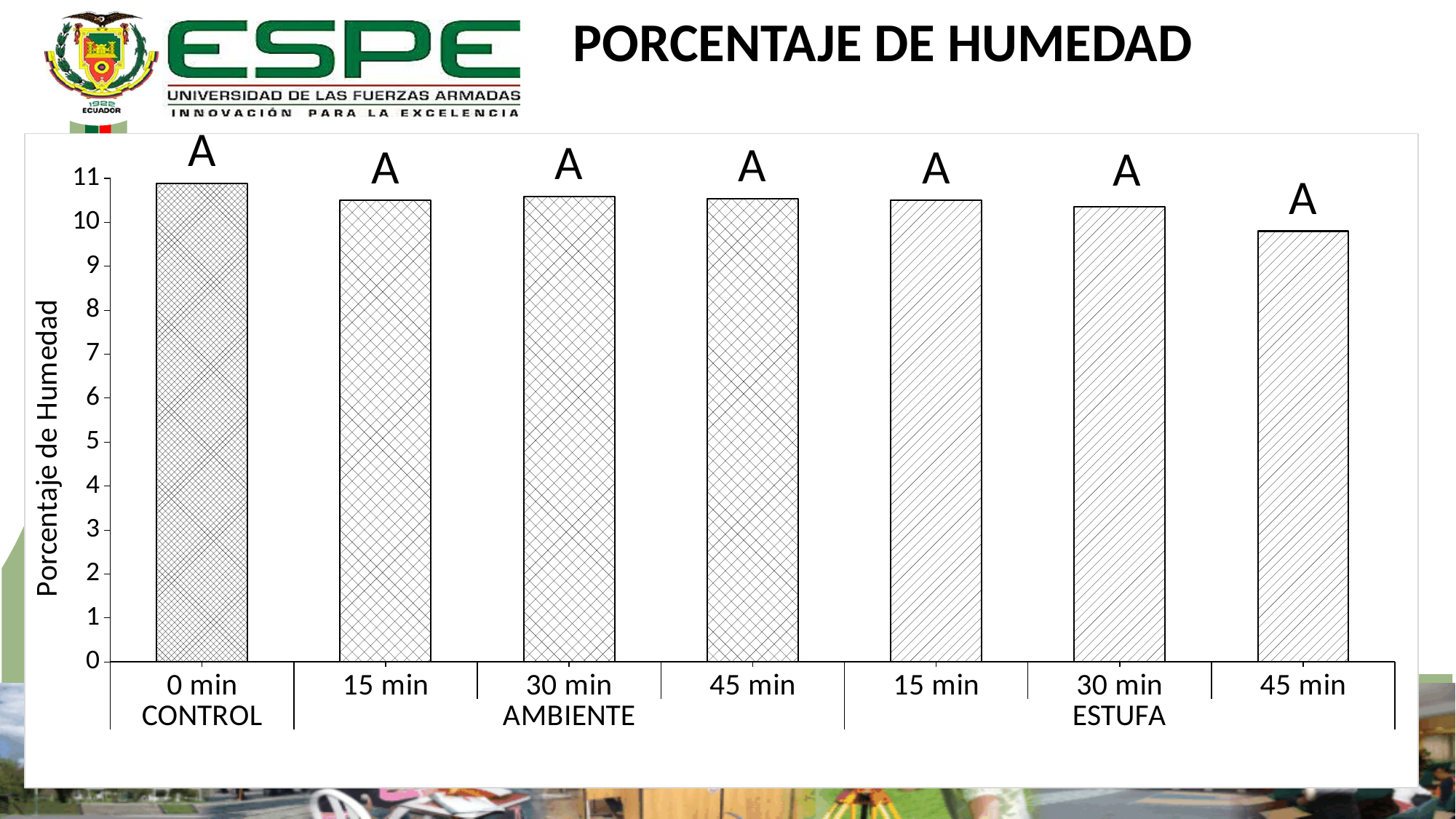
Is the value for 45 min ESTUFA greater or less than 10? less Within the ESTUFA group, do the values rise or fall from 15 min to 45 min? fall What is the label of the vertical axis? Porcentaje de Humedad How many bars are plotted in the chart? 7 Which bar has the lowest value? 45 min ESTUFA Which is larger, the value for 0 min CONTROL or the value for 45 min ESTUFA? 0 min CONTROL Which is larger, the value for 30 min ESTUFA or the value for 45 min ESTUFA? 30 min ESTUFA What is the title of the chart? PORCENTAJE DE HUMEDAD Is the value for 0 min CONTROL greater or less than 10? greater What kind of chart is shown on the slide? bar chart Is the value for 30 min ESTUFA greater or less than 9? greater Which bar has the highest value? 0 min CONTROL